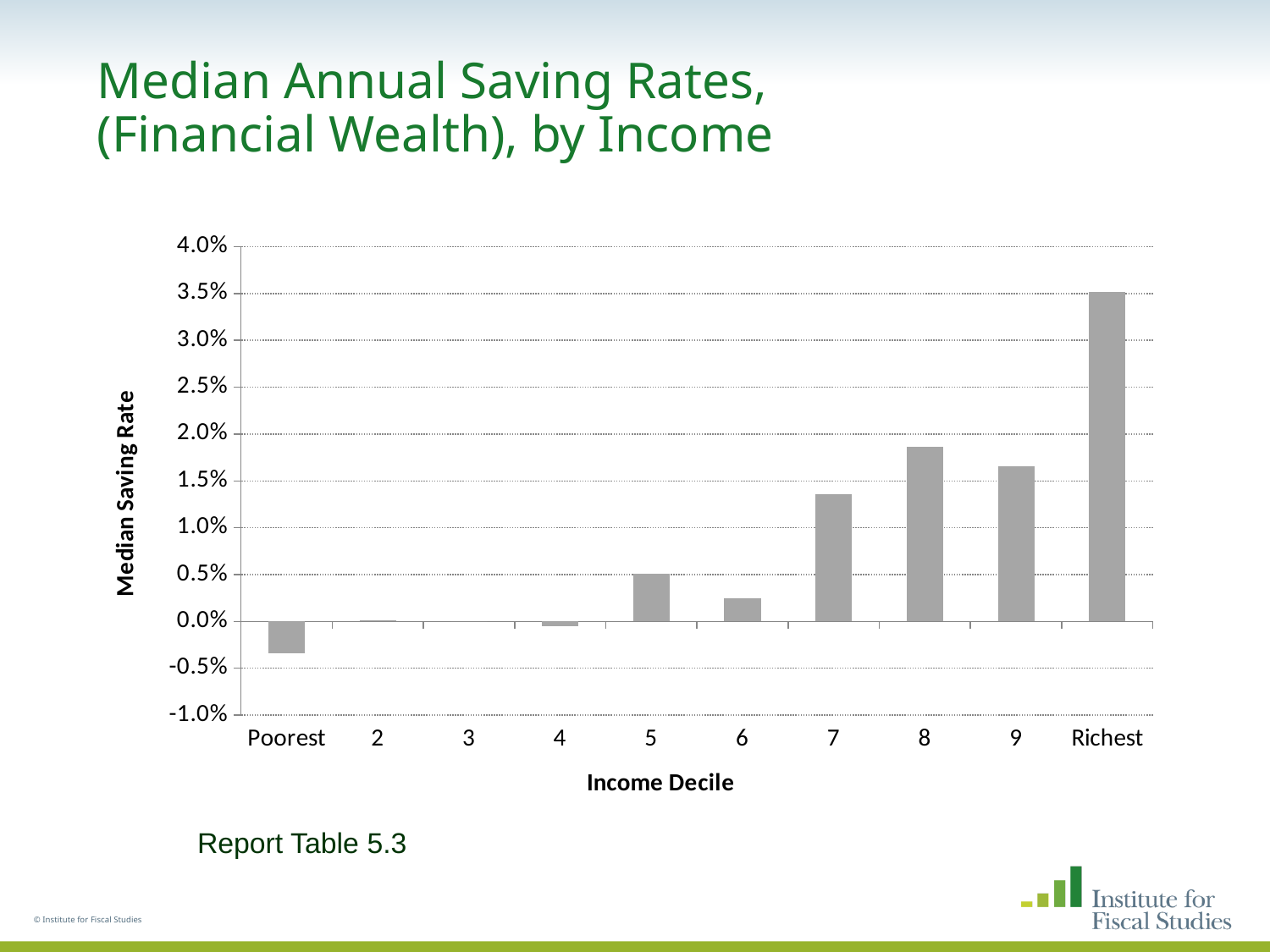
Is the median saving rate for decile 8 greater or less than 1.5%? greater Is the median saving rate for decile 7 greater or less than 1.0%? greater Which income decile has the lowest median saving rate? Poorest Which has a higher median saving rate, decile 8 or decile 9? decile 8 What is the label of the y axis? Median Saving Rate Is the median saving rate for decile 6 greater or less than 0.5%? less How many income deciles are shown on the x axis? 10 Do median saving rates generally rise or fall as income decile increases from Poorest to Richest? rise Which income decile has the highest median saving rate? Richest What kind of chart is shown on the slide? bar chart